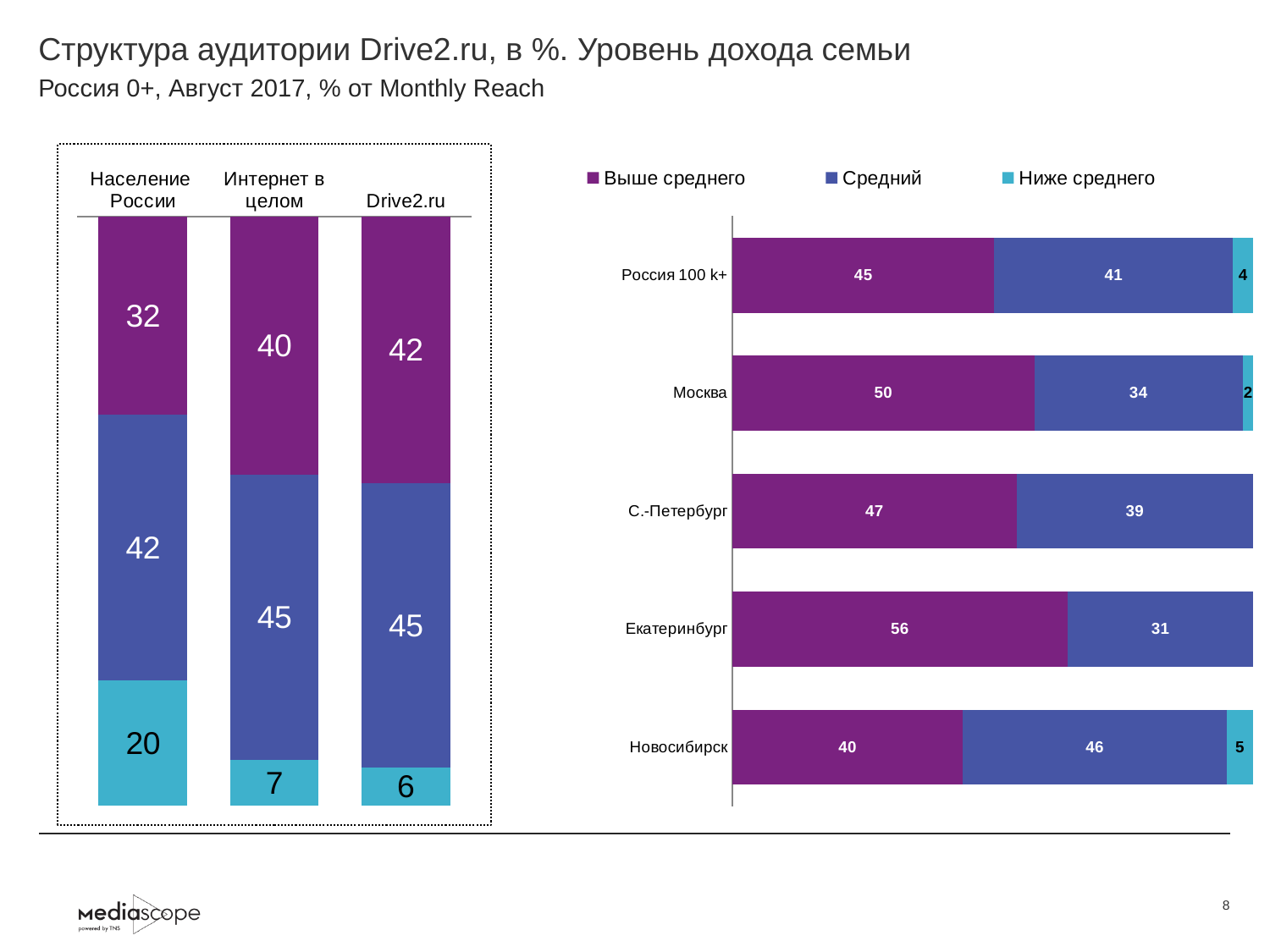
In the left chart, what is the value of the bottom (Ниже среднего) segment for Население России? 20 In the right chart, is the Выше среднего value larger for Москва or for Новосибирск? Москва In the left chart, how many categories are shown? 3 In the left chart, what is the value of the top (Выше среднего) segment for Drive2.ru? 42 In the left chart, which category has the lowest Ниже среднего value? Drive2.ru In the right chart, what is the Выше среднего value for Екатеринбург? 56 In the right chart, what is the Средний value for Новосибирск? 46 In the left chart, what is the difference between the Выше среднего values for Drive2.ru and Население России? 10 In the right chart, which city has the highest Выше среднего value? Екатеринбург In the right chart, what is the total of the labelled segments for Россия 100 k+? 90 In the left chart, what is the value of the middle (Средний) segment for Интернет в целом? 45 How many series does the legend of the right chart list? 3